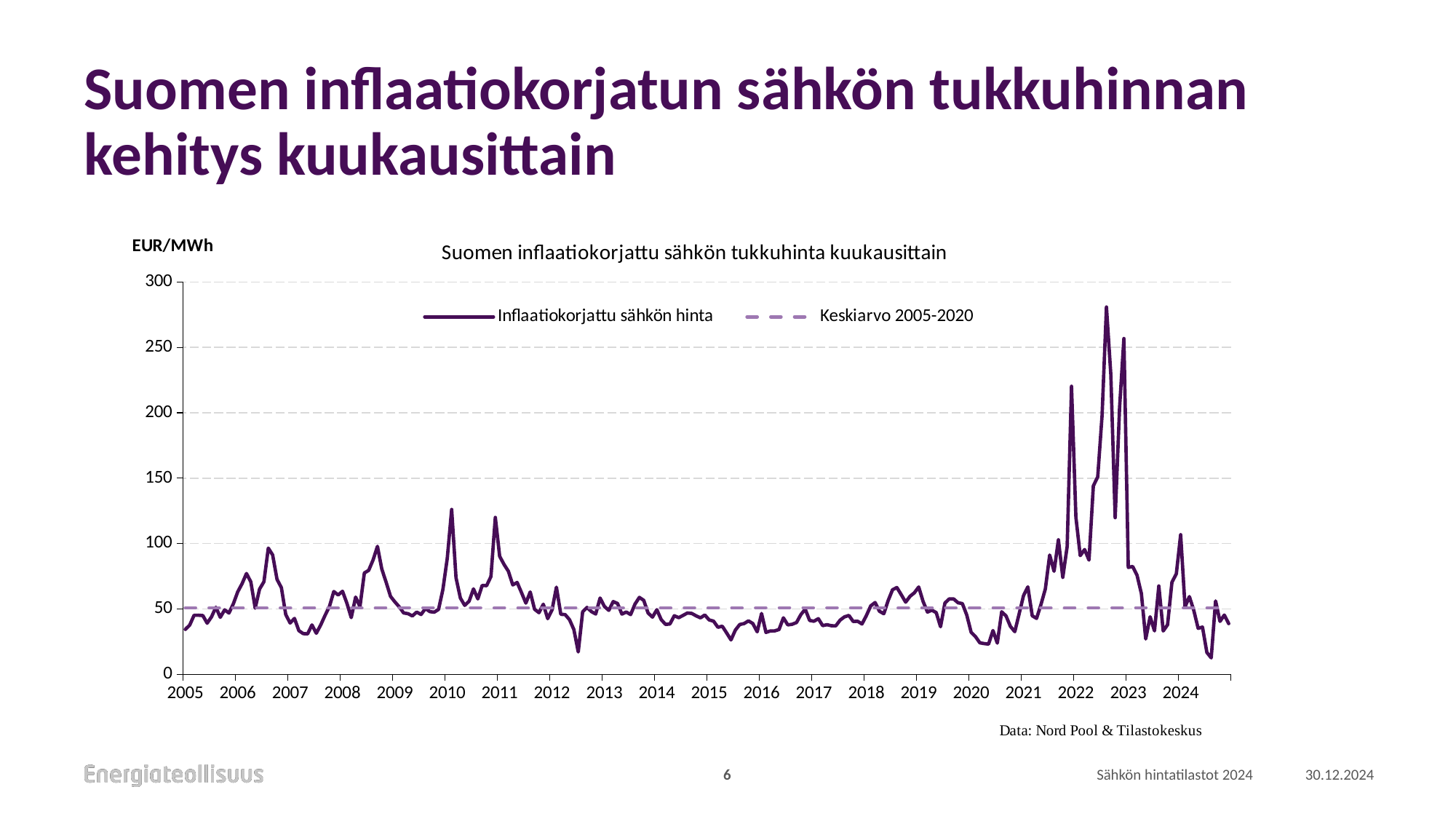
What is the title of the chart? Suomen inflaatiokorjattu sähkön tukkuhinta kuukausittain In which year does the Inflaatiokorjattu sähkön hinta line reach its highest peak? 2022 How many year labels are shown on the x axis? 20 What unit is shown on the y axis of the chart? EUR/MWh Is the peak of the Inflaatiokorjattu sähkön hinta line in early 2010 greater or less than 100? greater Is the lowest value of the Inflaatiokorjattu sähkön hinta line in 2012 greater or less than 50? less Does the Inflaatiokorjattu sähkön hinta line generally rise or fall from 2021 to 2022? rise Is the highest peak of the Inflaatiokorjattu sähkön hinta line in 2022 greater or less than 250? greater What kind of chart is shown on the slide? line chart Which is larger: the peak of the Inflaatiokorjattu sähkön hinta line in 2022 or its peak in 2010? 2022 How many series does the chart legend list? 2